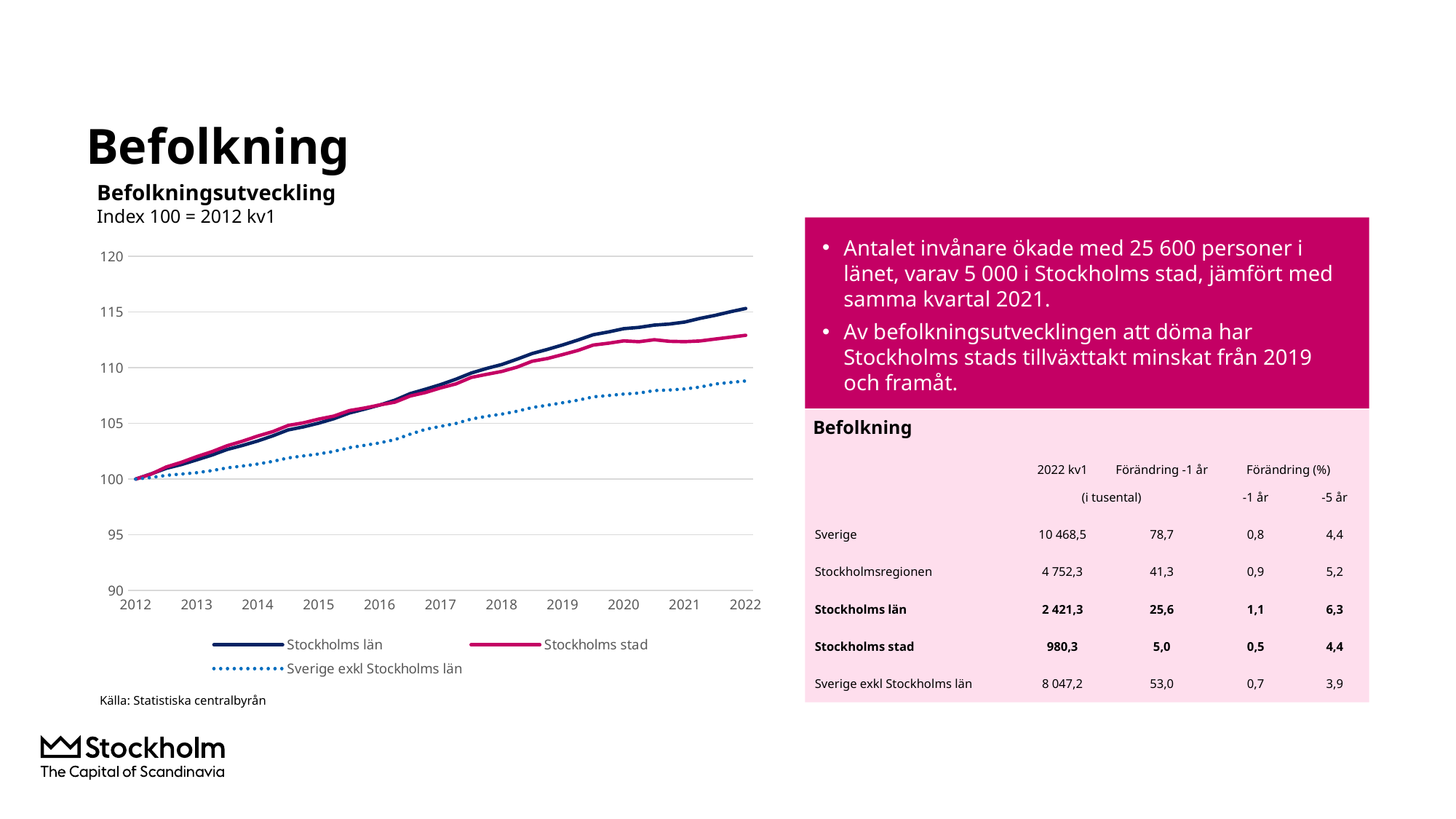
Is the value for Sverige exkl Stockholms län in 2022 greater or less than 110? less In 2022, which is larger: the value for Stockholms län or the value for Stockholms stad? Stockholms län What is the index value for all three series at the start of 2012? 100 What is the title of the chart? Befolkningsutveckling Which series has the highest value at the end of the chart in 2022? Stockholms län Is the value for Stockholms stad in 2022 greater or less than 115? less Which series has the lowest value at the end of the chart in 2022? Sverige exkl Stockholms län How many series does the chart legend list? 3 Do the values for Stockholms län rise or fall from 2012 to 2022? rise How many years are labelled on the x axis of the chart? 11 What kind of chart is shown on the slide? line chart